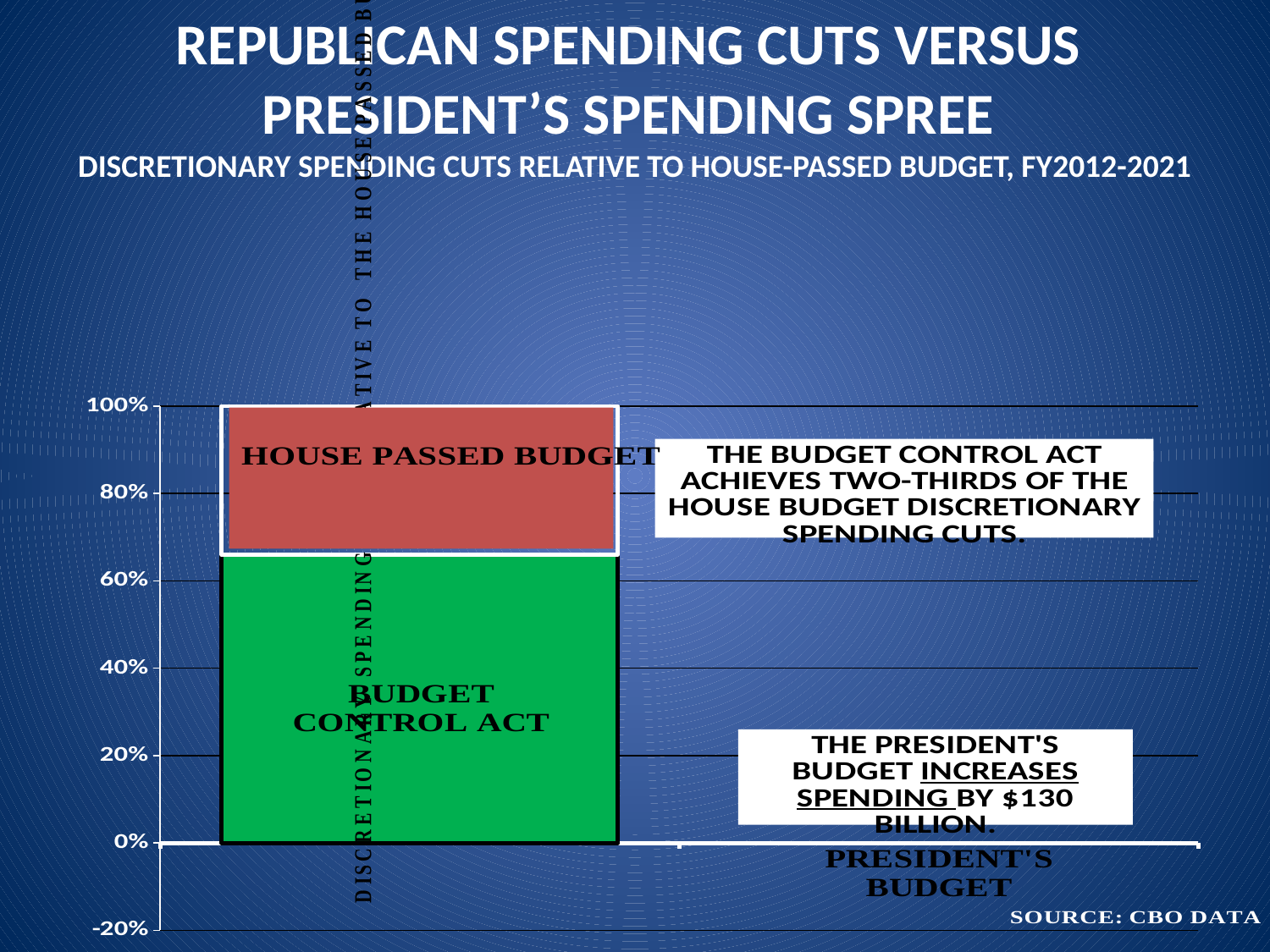
Is the value for the President's Budget greater or less than 20%? less Which segment of the stacked bar is larger, Budget Control Act or House Passed Budget? Budget Control Act What value on the axis does the top of the House Passed Budget bar reach? 100% Is the value for the Budget Control Act greater or less than 80%? less What kind of chart is shown on the slide? bar chart Is the value for the Budget Control Act greater or less than 60%? greater What is the lowest value shown on the vertical axis? -20% What source is cited for the chart data? CBO Data What is the highest value shown on the vertical axis? 100%